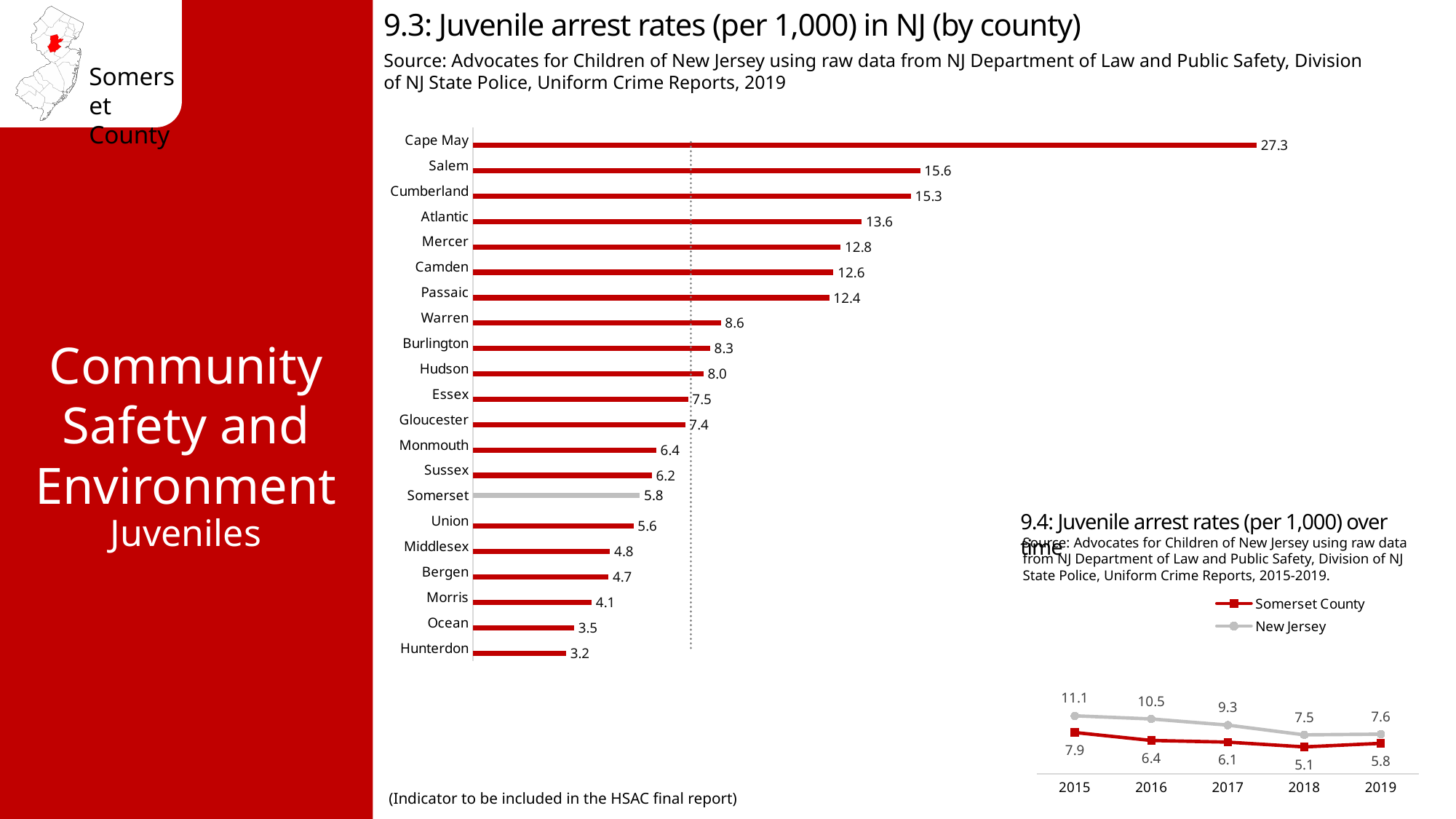
In the chart '9.3: Juvenile arrest rates (per 1,000) in NJ (by county)', what is the difference between the values for Salem and Cumberland? 0.3 In the chart '9.3: Juvenile arrest rates (per 1,000) in NJ (by county)', which is larger, the value for Mercer or the value for Passaic? Mercer In the chart '9.4: Juvenile arrest rates (per 1,000) over time', what is the difference between the New Jersey and Somerset County values in 2015? 3.2 In the chart '9.3: Juvenile arrest rates (per 1,000) in NJ (by county)', what is the value for Atlantic? 13.6 In the chart '9.3: Juvenile arrest rates (per 1,000) in NJ (by county)', which county has the highest value? Cape May In the chart '9.3: Juvenile arrest rates (per 1,000) in NJ (by county)', which county has the lowest value? Hunterdon In the chart '9.4: Juvenile arrest rates (per 1,000) over time', what is the value for New Jersey in 2017? 9.3 What kind of chart is '9.3: Juvenile arrest rates (per 1,000) in NJ (by county)'? Bar chart In the chart '9.4: Juvenile arrest rates (per 1,000) over time', what is the value for Somerset County in 2018? 5.1 In the chart '9.3: Juvenile arrest rates (per 1,000) in NJ (by county)', what is the value for Somerset? 5.8 In the chart '9.4: Juvenile arrest rates (per 1,000) over time', how many series does the legend list? 2 In the chart '9.3: Juvenile arrest rates (per 1,000) in NJ (by county)', how many counties are shown? 21